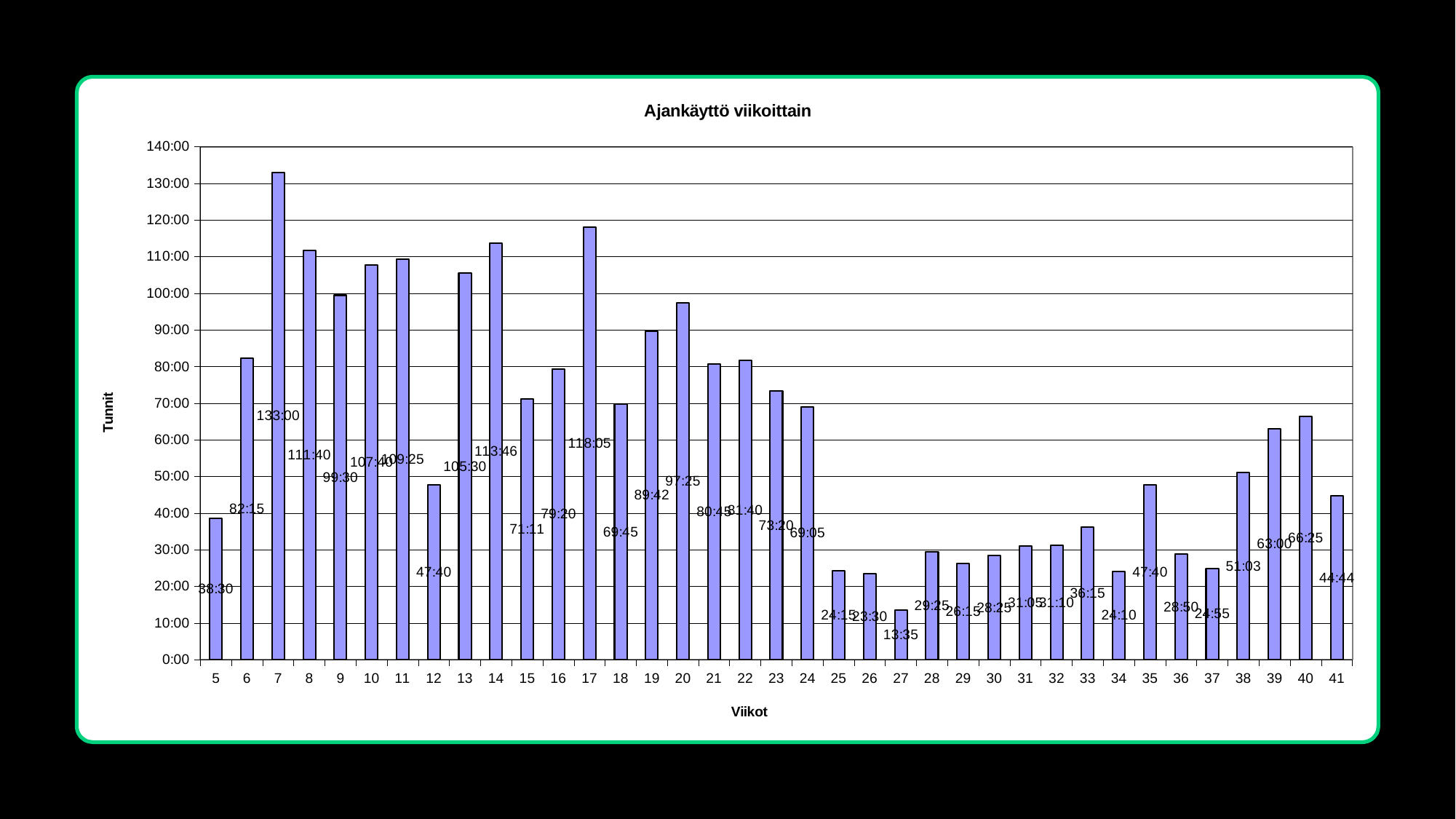
Which week has the lowest value? 27 What is the value for week 27? 13:35 Which has the larger value, week 39 or week 40? week 40 What is the value for week 17? 118:05 What is the title of the chart? Ajankäyttö viikoittain Is the value for week 35 greater or less than 50:00? less How many weeks are shown on the x axis? 37 What kind of chart is shown on the slide? bar chart Which week has the highest value? 7 What is the difference between the values for week 7 and week 17? 14:55 What is the value for week 7? 133:00 What is the value for week 41? 44:44